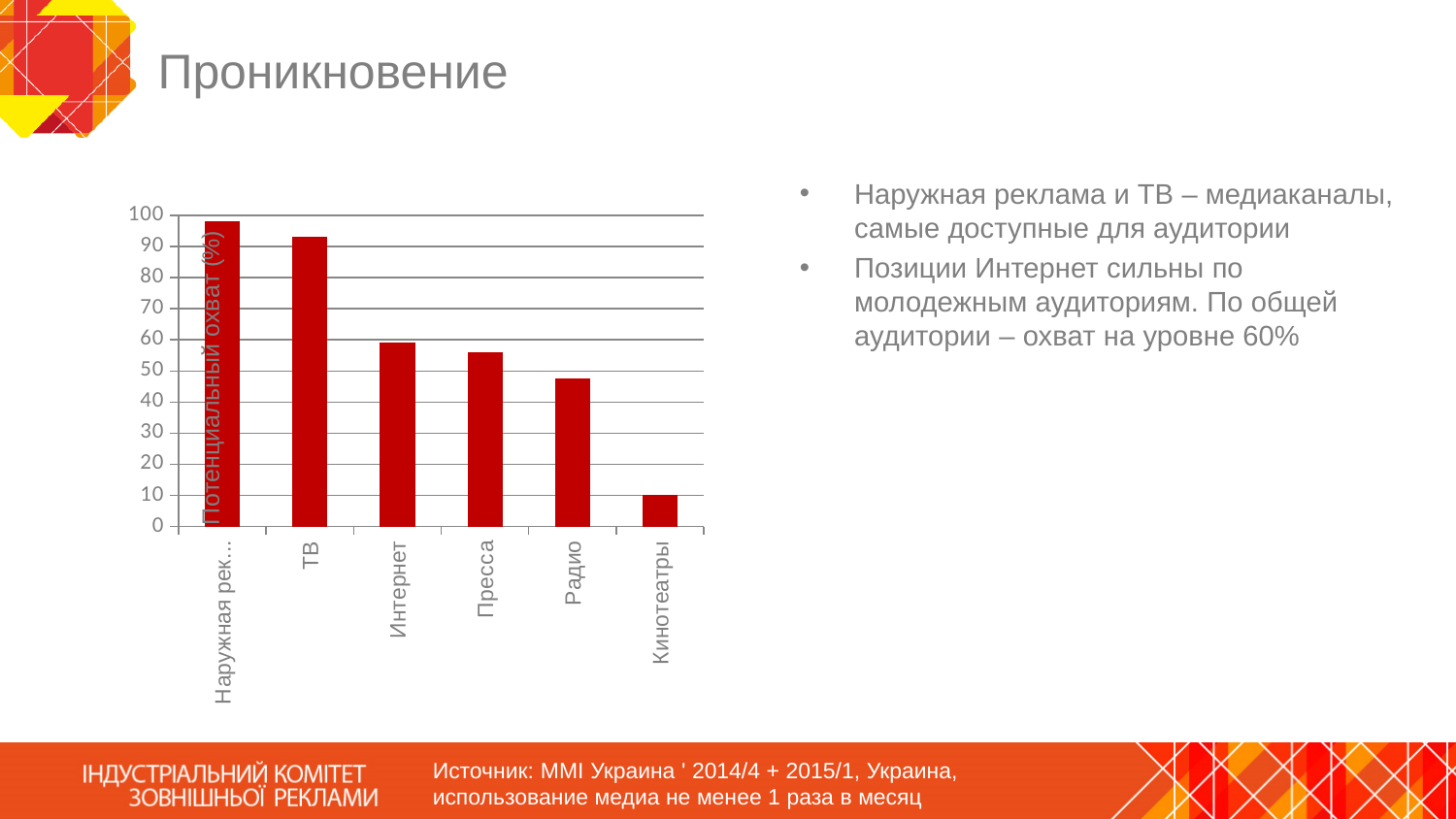
Is the value for Радио greater or less than 50? less Which category has the lowest bar on the chart? Кинотеатры Which category has the highest bar on the chart? Наружная реклама How many categories are plotted on the chart? 6 What is the title of the vertical axis on the chart? Потенциальный охват (%) Which is larger, the value for Пресса or the value for Радио? Пресса What kind of chart is shown on the slide? bar chart Is the value for Кинотеатры greater or less than 20? less Is the value for ТВ greater or less than 90? greater Do the bar values rise or fall from left to right along the x axis? fall Which is larger, the value for ТВ or the value for Интернет? ТВ